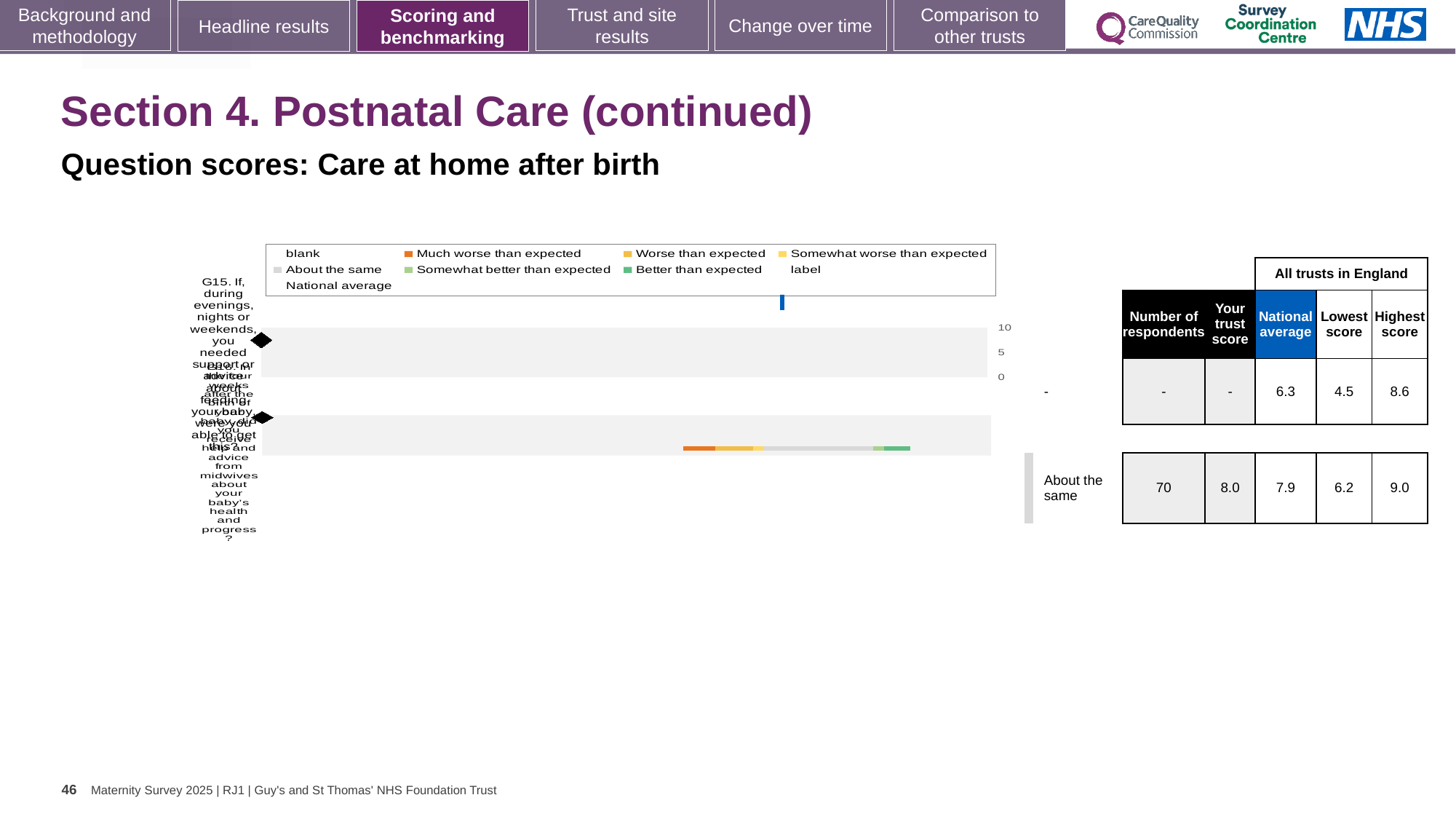
In the table beside the chart, what is the highest score among all trusts in England for the question rated 'About the same'? 9.0 In the table beside the chart, what is the lowest score among all trusts in England for the first question row? 4.5 In the table beside the chart, what is the national average for the first question row? 6.3 For the question rated 'About the same', what is the difference between the highest score (9.0) and the lowest score (6.2)? 2.8 For the question rated 'About the same', which is larger: the trust score or the national average? the trust score In the table beside the chart, what is the national average for the question rated 'About the same'? 7.9 In the table beside the chart, how many respondents are listed for the question rated 'About the same'? 70 In the table beside the chart, what is the 'Your trust score' for the question rated 'About the same'? 8.0 In the chart legend, what colour represents 'Better than expected'? green What is the maximum value shown on the chart's numeric axis? 10 What kind of chart is shown on the slide? bar chart In the chart legend, what colour represents 'Much worse than expected'? orange